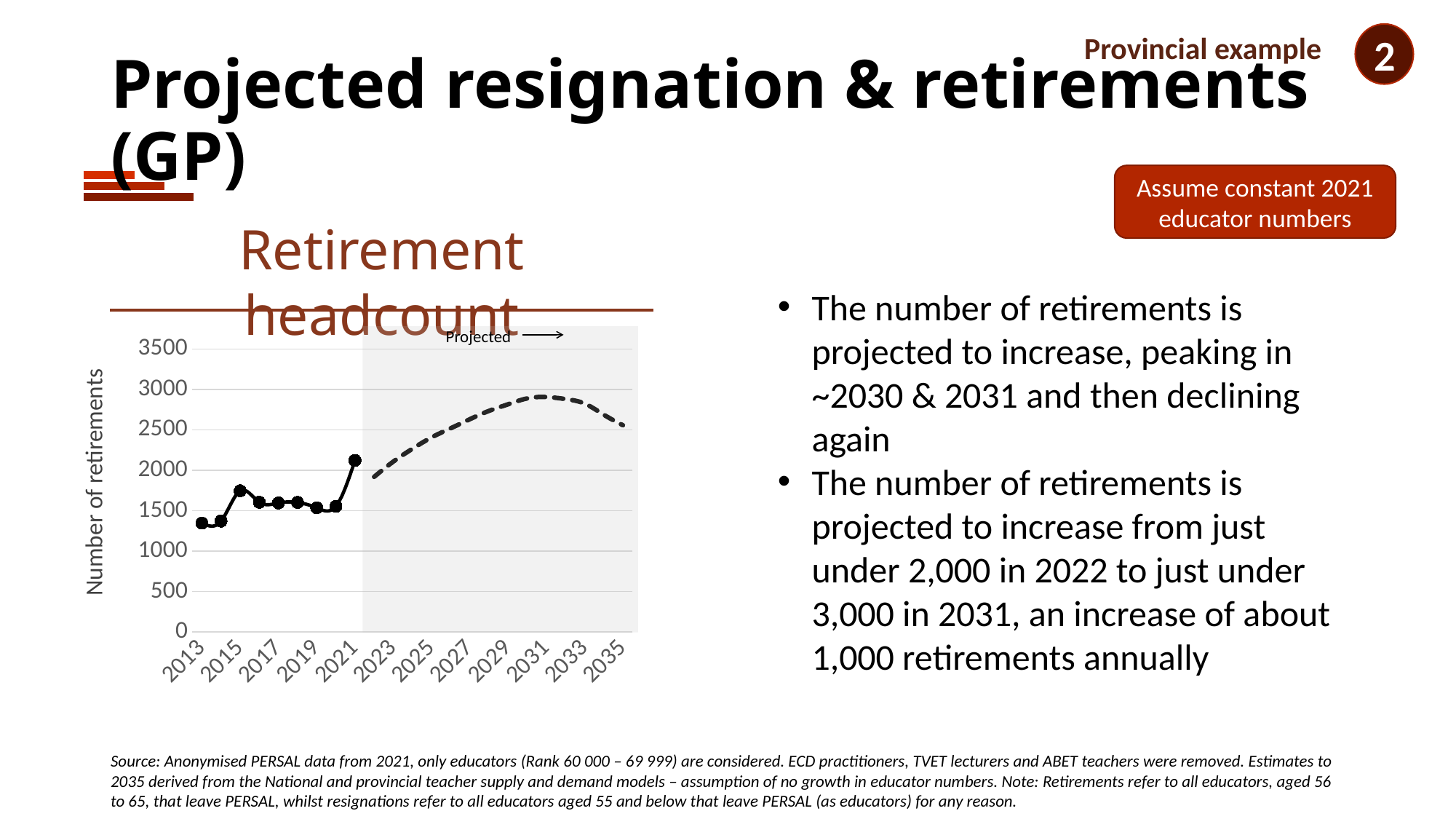
Among the solid-line (actual) data points from 2013 to 2021, which year has the highest number of retirements? 2021 Is the projected value for 2031 greater or less than 2500? greater What is the title of the chart on the slide? Retirement headcount What kind of chart is the 'Retirement headcount' chart? line chart What is the label on the vertical axis of the chart? Number of retirements Is the value for 2021 greater or less than 2000? greater Is the value for 2013 greater or less than 1500? less Which is larger, the number of retirements in 2021 or in 2013? 2021 Does the projected (dashed) line rise or fall between 2031 and 2035? fall How many year labels are shown on the x axis? 12